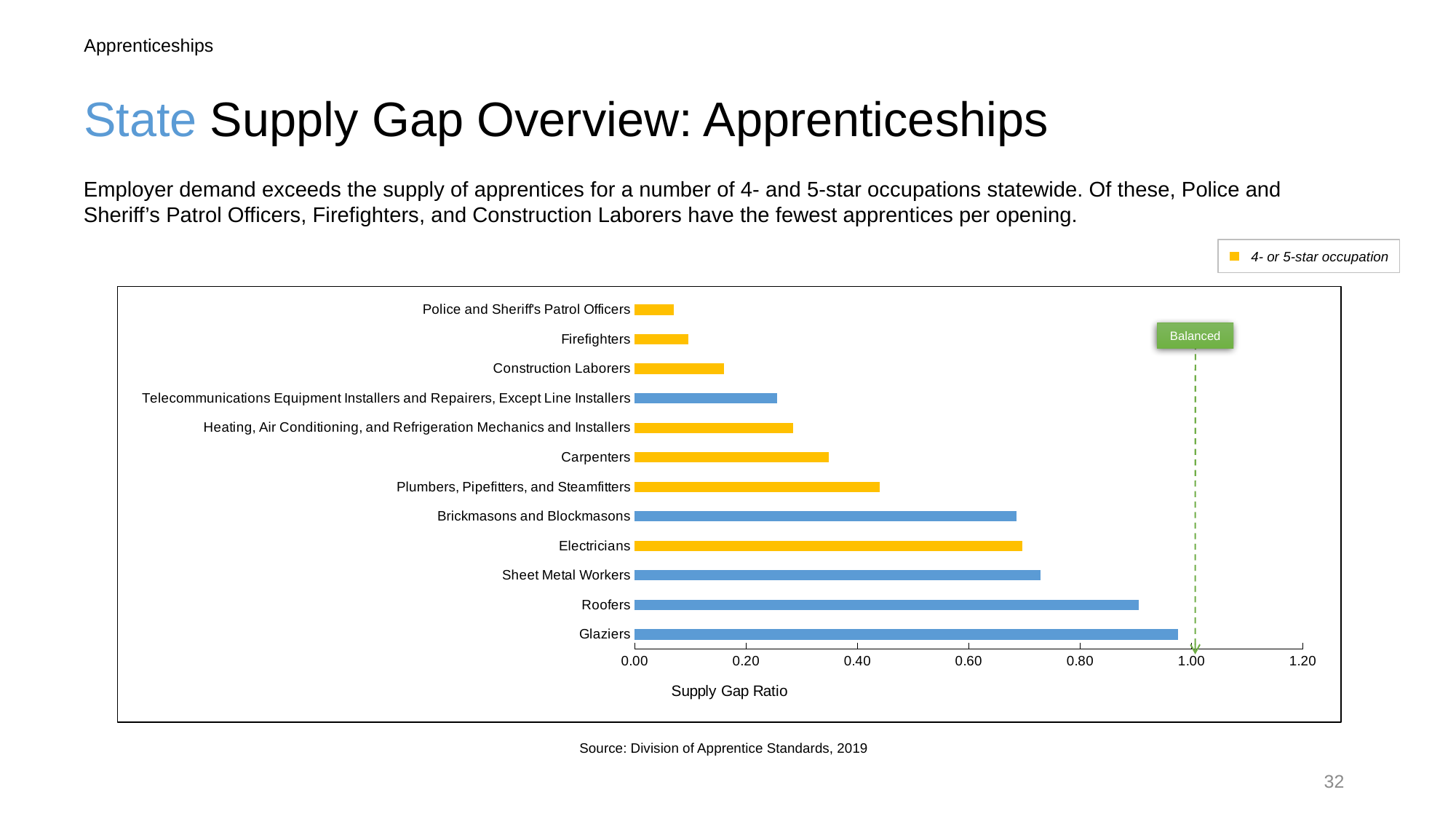
What is the title of the x axis? Supply Gap Ratio Is the supply gap ratio for Roofers greater or less than 0.80? greater At what x-axis value is the dashed 'Balanced' line drawn? 1.00 Which has a larger supply gap ratio, Roofers or Sheet Metal Workers? Roofers Which occupation has the highest supply gap ratio? Glaziers What kind of chart is shown on the slide? Bar chart How many occupations are plotted in the chart? 12 Which has a larger supply gap ratio, Carpenters or Plumbers, Pipefitters, and Steamfitters? Plumbers, Pipefitters, and Steamfitters How many entries does the legend list? 1 Is the supply gap ratio for Glaziers greater or less than 1.00? less Which occupation has the lowest supply gap ratio? Police and Sheriff's Patrol Officers Is the supply gap ratio for Construction Laborers greater or less than 0.20? less